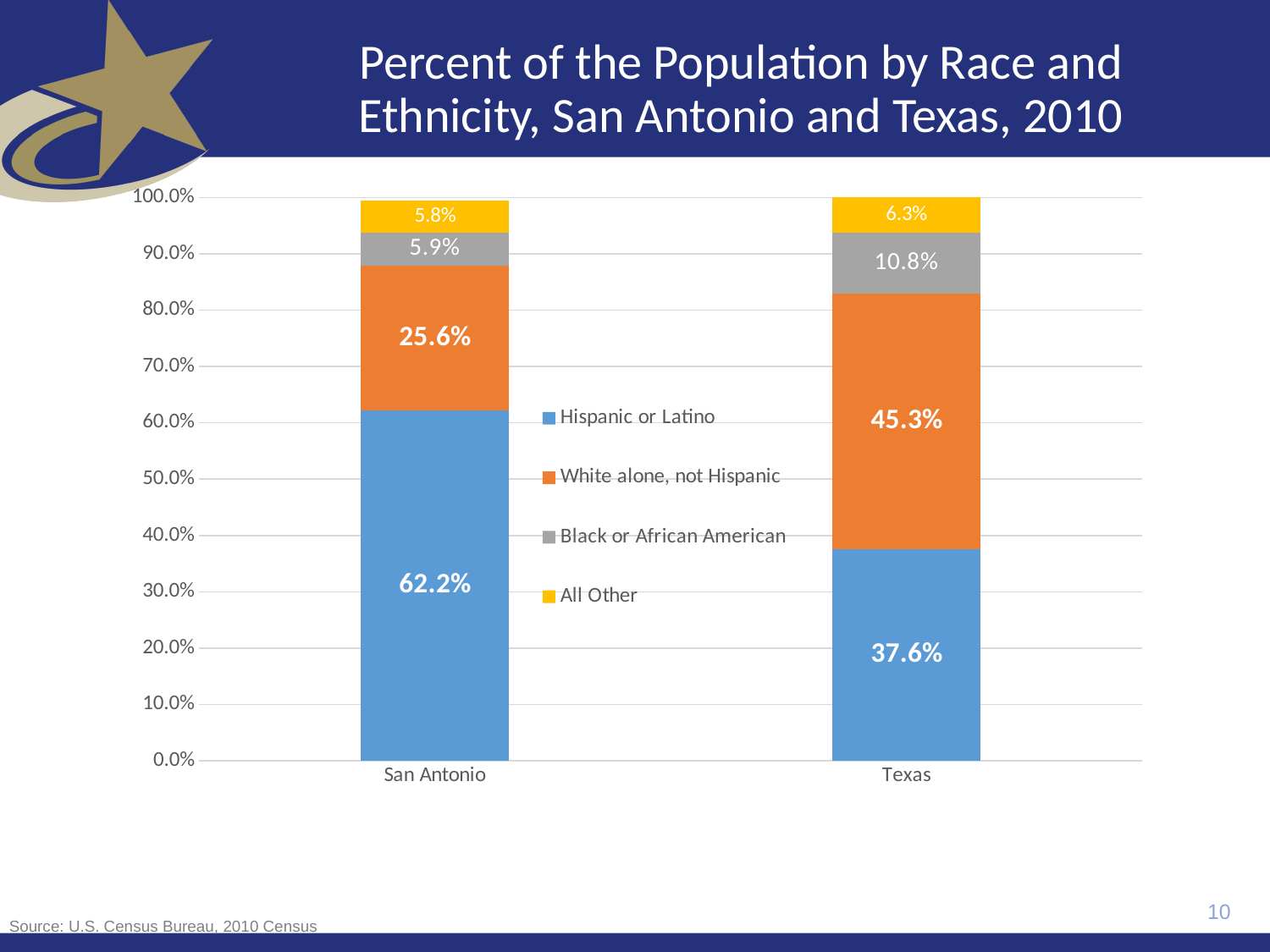
What is the White alone, not Hispanic percentage for Texas? 45.3% How many series does the legend list? 4 What is the difference between the Hispanic or Latino percentages for San Antonio and Texas? 24.6% What is the Hispanic or Latino percentage for San Antonio? 62.2% What is the All Other percentage for San Antonio? 5.8% Which category has the larger Hispanic or Latino share, San Antonio or Texas? San Antonio What is the difference between the White alone, not Hispanic percentages for Texas and San Antonio? 19.7% Which series is the largest segment in the Texas bar? White alone, not Hispanic What is the Black or African American percentage for Texas? 10.8% Which series is the smallest segment in the San Antonio bar? All Other What is the total of the stacked bar for Texas? 100.0% What kind of chart is shown on the slide? Stacked bar chart